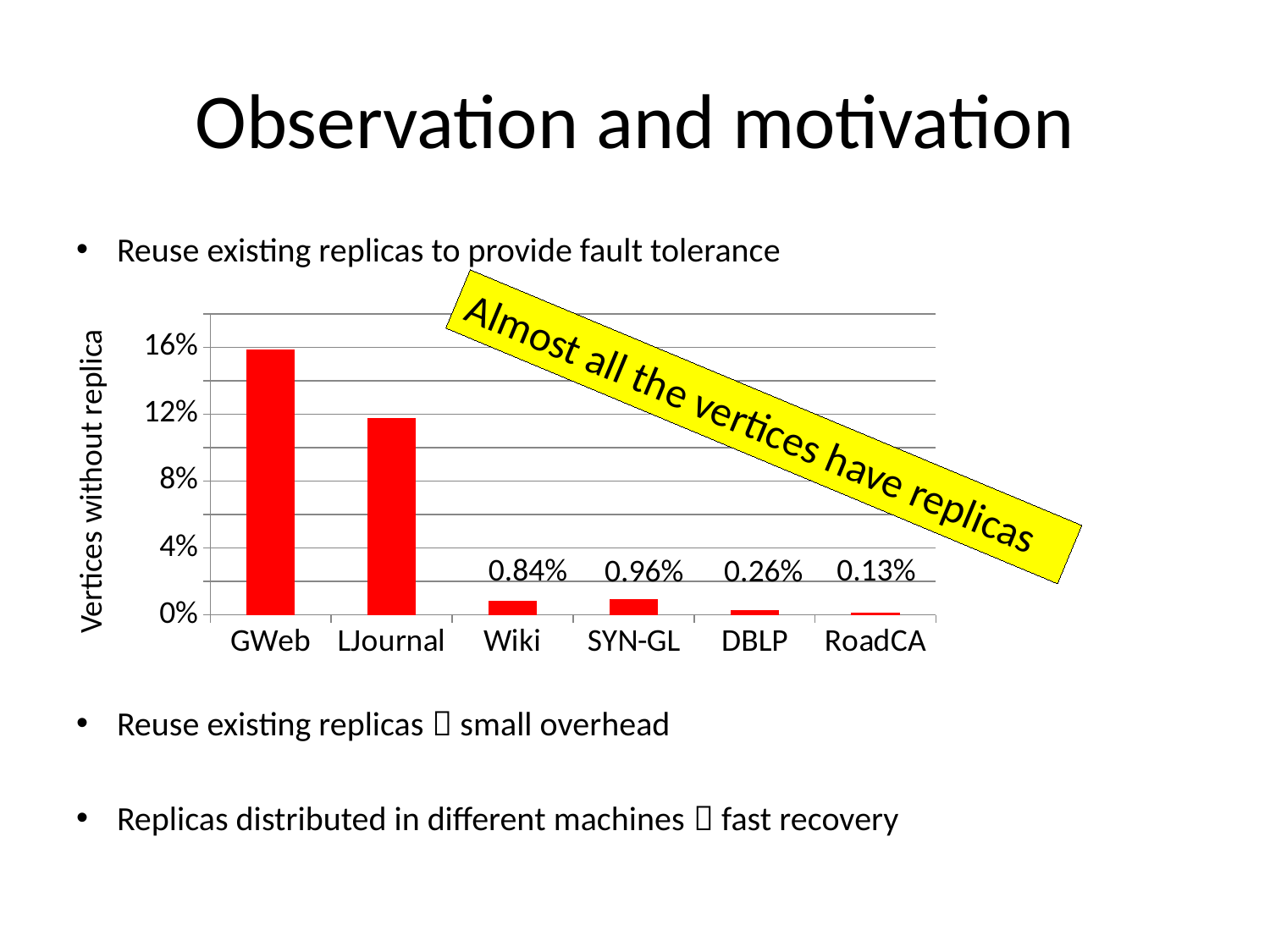
Which category has the highest value? GWeb What is the value for SYN-GL? 0.96% What is the value for Wiki? 0.84% Is the value for GWeb greater or less than 12%? greater What is the value for RoadCA? 0.13% How many categories are shown on the x axis? 6 Is the value for LJournal greater or less than 8%? greater What is the value for DBLP? 0.26% Which is larger, the value for Wiki or the value for SYN-GL? SYN-GL Which category has the lowest value? RoadCA What kind of chart is shown on the slide? bar chart What is the difference between the values for SYN-GL and Wiki? 0.12%